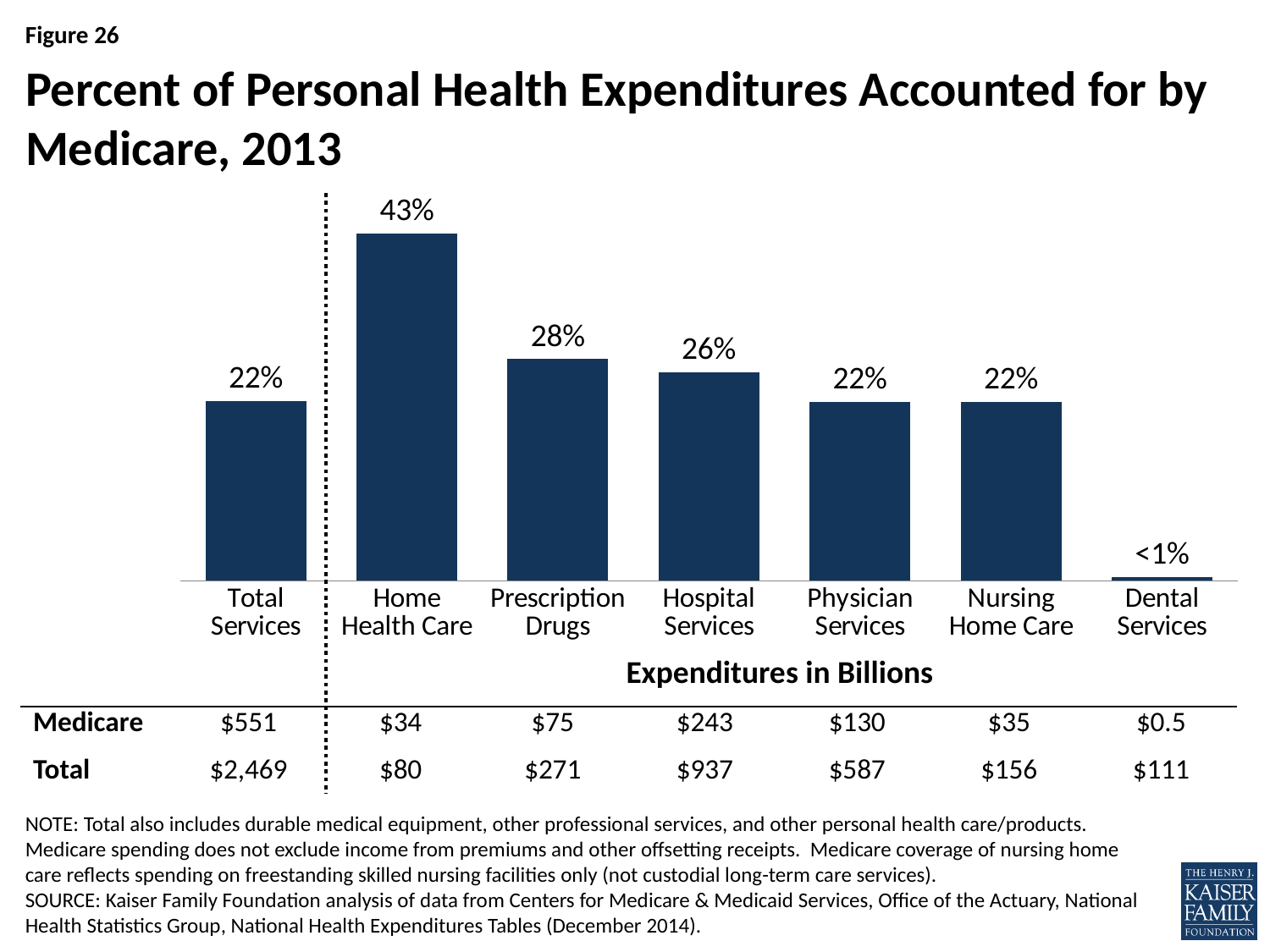
Which category has the lowest Medicare percentage? Dental Services How many categories are shown on the chart? 7 What percent of Prescription Drugs expenditures is accounted for by Medicare? 28% Which category has the highest Medicare percentage? Home Health Care What is the Medicare share shown for Hospital Services? 26% According to the table below the chart, what are Medicare expenditures in billions for Hospital Services? $243 What is the difference in percentage points between Home Health Care and Total Services? 21 What percent of personal health expenditures for Home Health Care is accounted for by Medicare? 43% What kind of chart is shown on the slide? Bar chart What value is shown for Dental Services? <1% According to the table below the chart, what are total expenditures in billions for Total Services? $2,469 Which is larger, the Medicare percentage for Prescription Drugs or for Hospital Services? Prescription Drugs